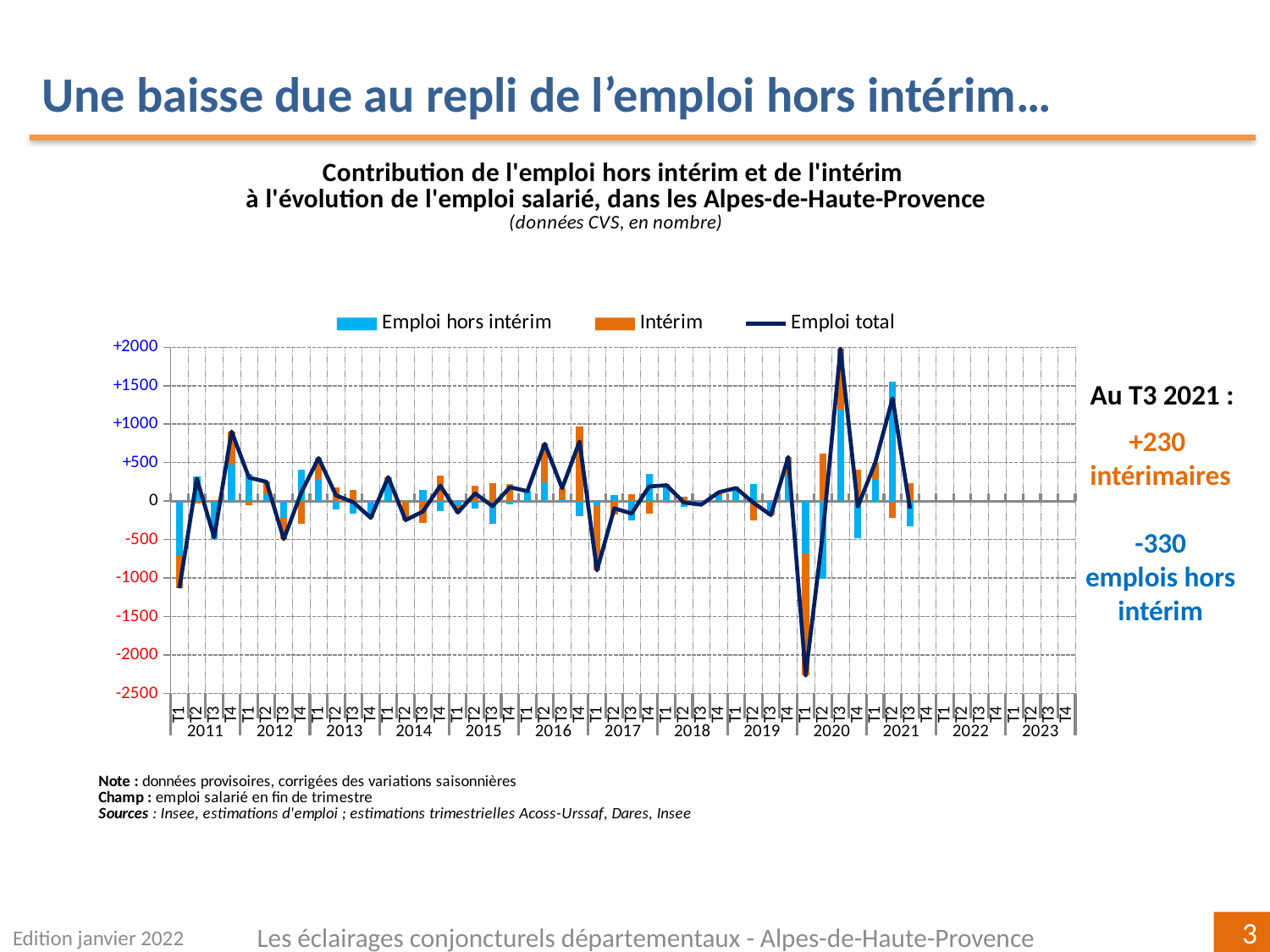
According to the annotation, what is the value for Intérim at T3 2021? +230 What kind of chart is this? A combined bar and line chart In which quarter does the Emploi total line reach its lowest point? T1 2020 What is the last year shown on the x axis? 2023 What colour are the Intérim bars? Orange In which quarter does the Emploi total line reach its highest point? T3 2020 According to the annotation, what is the value for Emploi hors intérim at T3 2021? -330 Is the Emploi hors intérim bar at T2 2021 greater or less than +1000? greater How many series does the legend list? 3 Is the value of Emploi total at T1 2020 greater or less than -2000? less Is the value of Emploi total at T3 2020 greater or less than +1500? greater Which is larger for Emploi total: the value at T3 2020 or the value at T2 2021? T3 2020